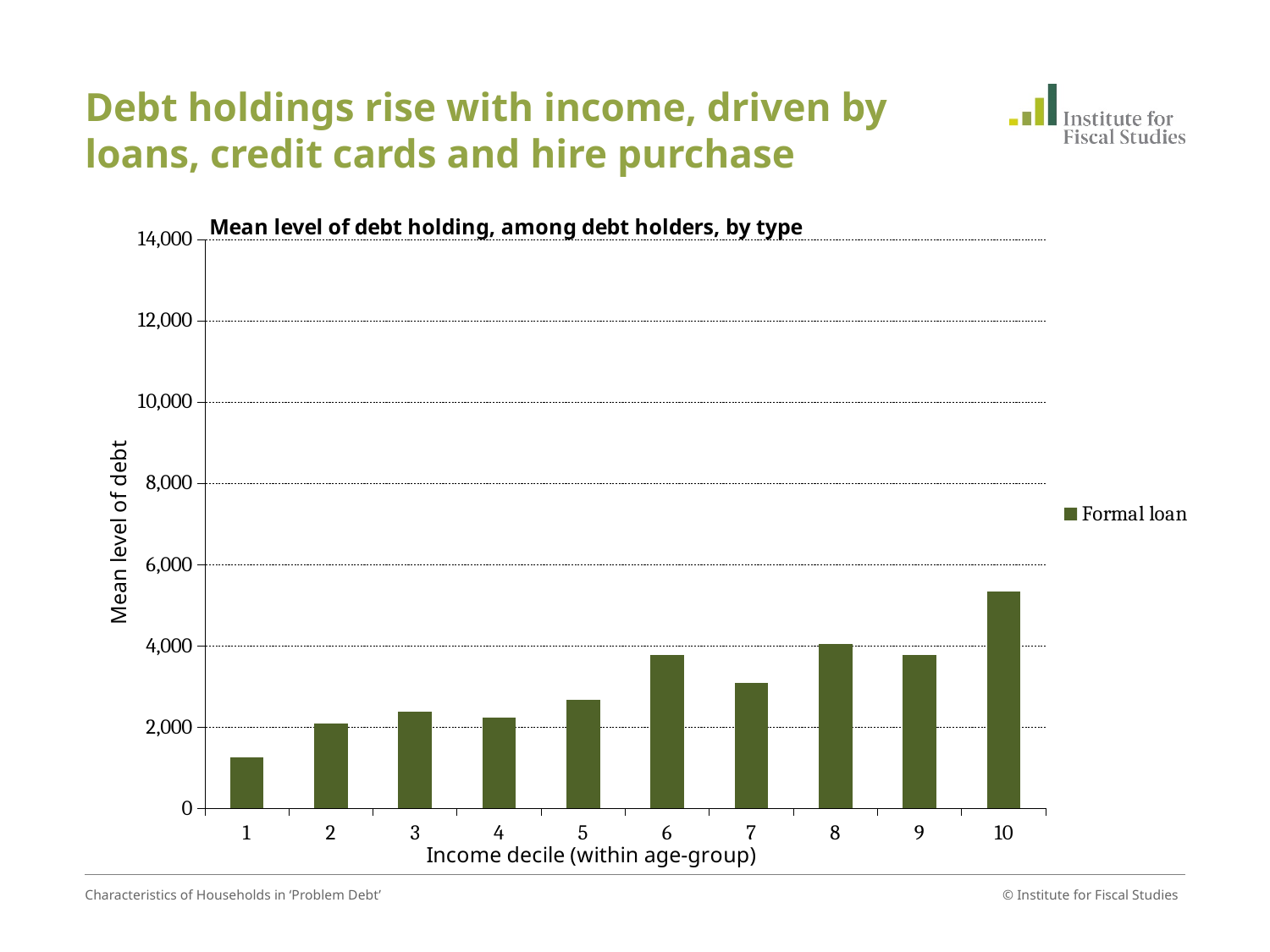
What kind of chart is shown on the slide? bar chart How many income deciles are shown on the x axis? 10 Is the value for income decile 10 greater or less than 4,000? greater Is the value for income decile 1 greater or less than 2,000? less Which has a higher mean level of debt, income decile 6 or income decile 7? 6 Is the value for income decile 6 greater or less than 4,000? less What is the title of the chart? Mean level of debt holding, among debt holders, by type Which income decile has the lowest mean level of formal loan debt? 1 Which income decile has the highest mean level of formal loan debt? 10 Overall, do the bars rise or fall as the income decile increases from 1 to 10? rise How many series does the legend list? 1